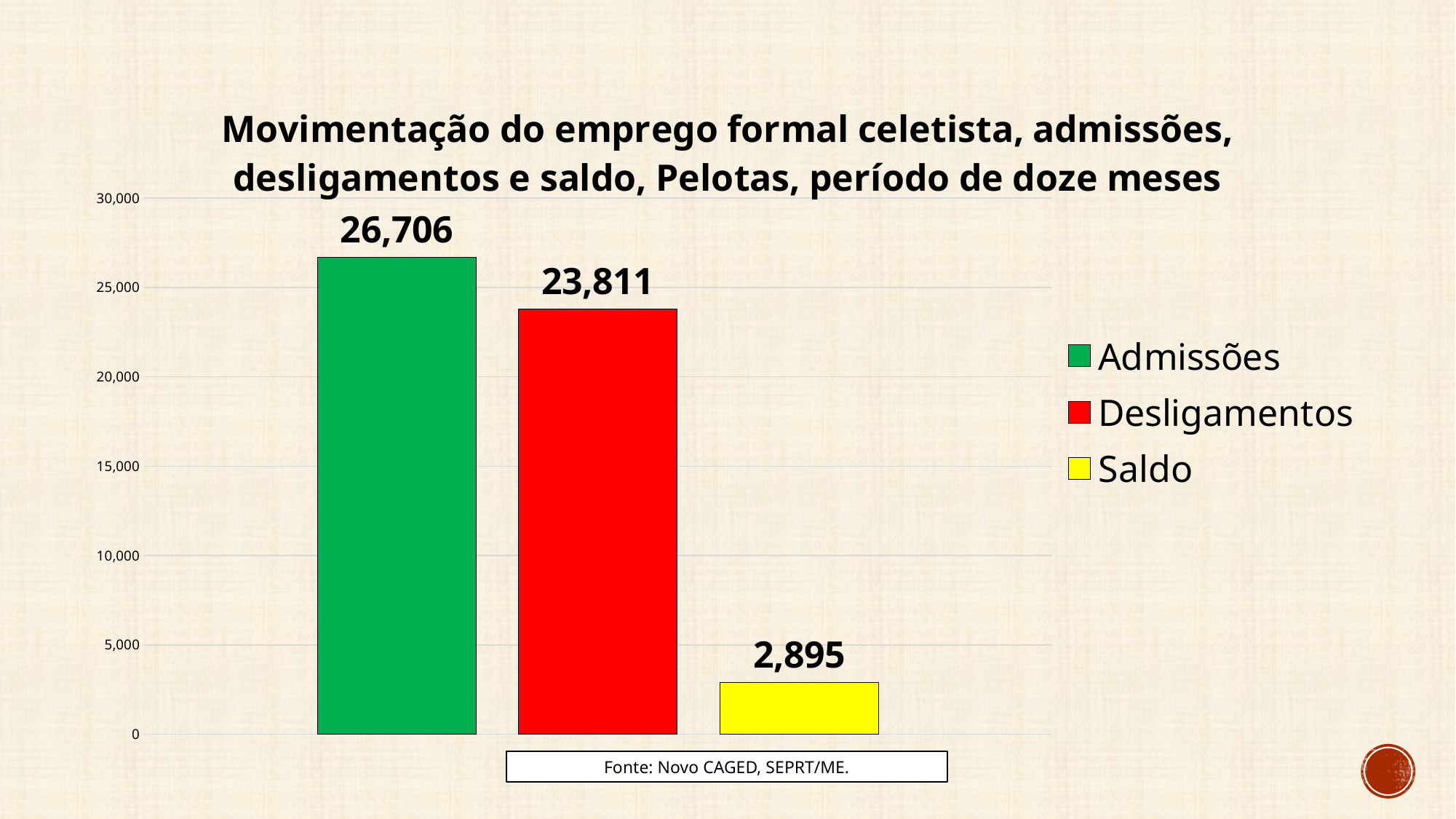
What is the value for Admissões? 26,706 Which series has the highest value? Admissões How many bars are plotted in the chart? 3 What is the difference between Admissões and Desligamentos? 2,895 What is the value for Desligamentos? 23,811 Which series has the lowest value? Saldo What kind of chart is shown on the slide? bar chart What is the value for Saldo? 2,895 Which is larger, Desligamentos or Saldo? Desligamentos What colour is the bar for Saldo? yellow How many series does the legend list? 3 Is the value for Desligamentos greater or less than 25,000? less